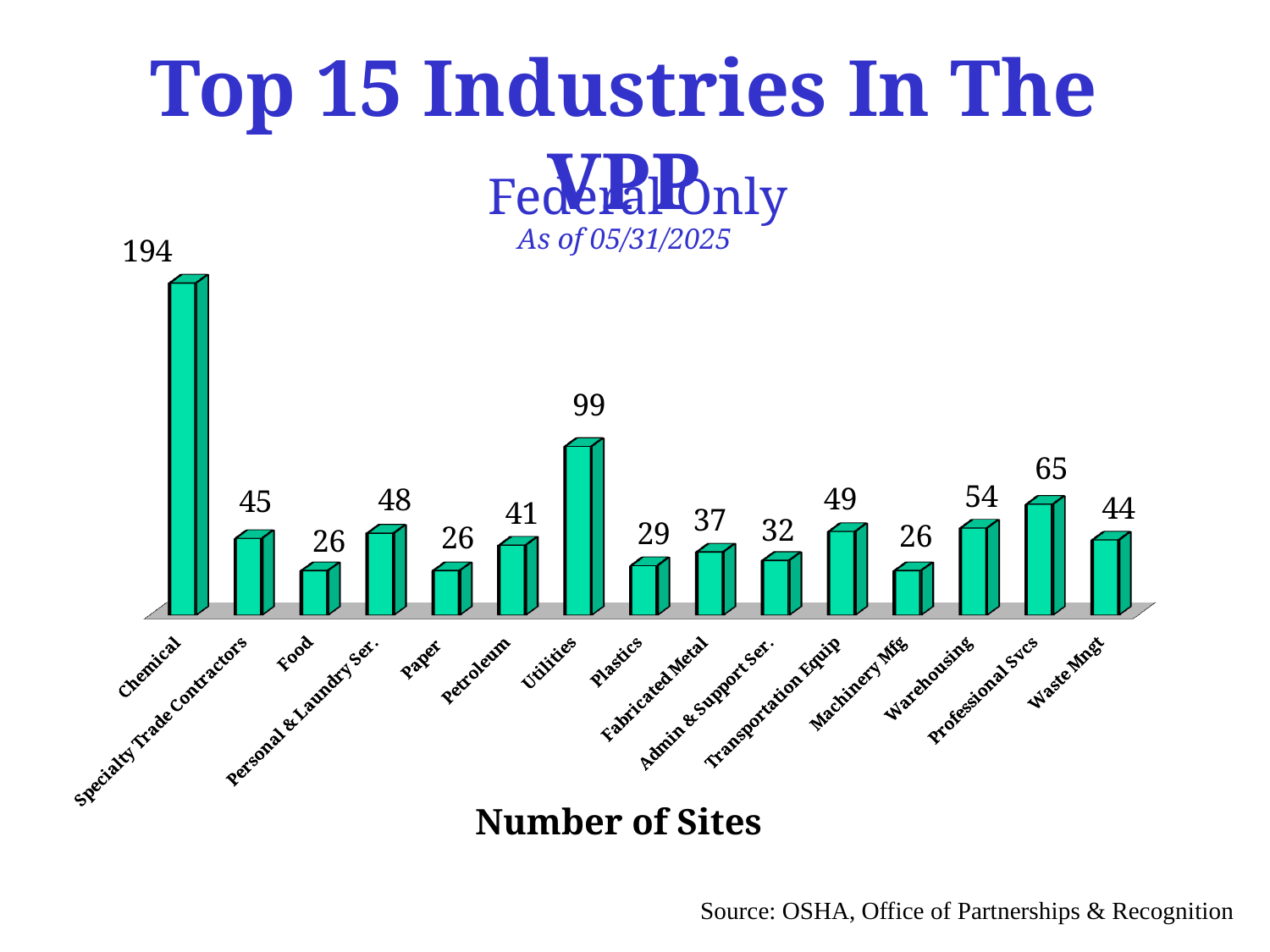
What is the difference in number of sites between Warehousing and Petroleum? 13 Which has more sites, Fabricated Metal or Admin & Support Ser.? Fabricated Metal Which industry has the highest number of sites? Chemical What is the number of sites for Professional Svcs? 65 Which has more sites, Specialty Trade Contractors or Personal & Laundry Ser.? Personal & Laundry Ser. What is the number of sites for Utilities? 99 What is the number of sites for Transportation Equip? 49 How many industries are shown in the chart? 15 What is the label on the horizontal axis of the chart? Number of Sites What is the number of sites for Chemical? 194 What kind of chart is shown on the slide? Bar chart What is the difference in number of sites between Chemical and Utilities? 95